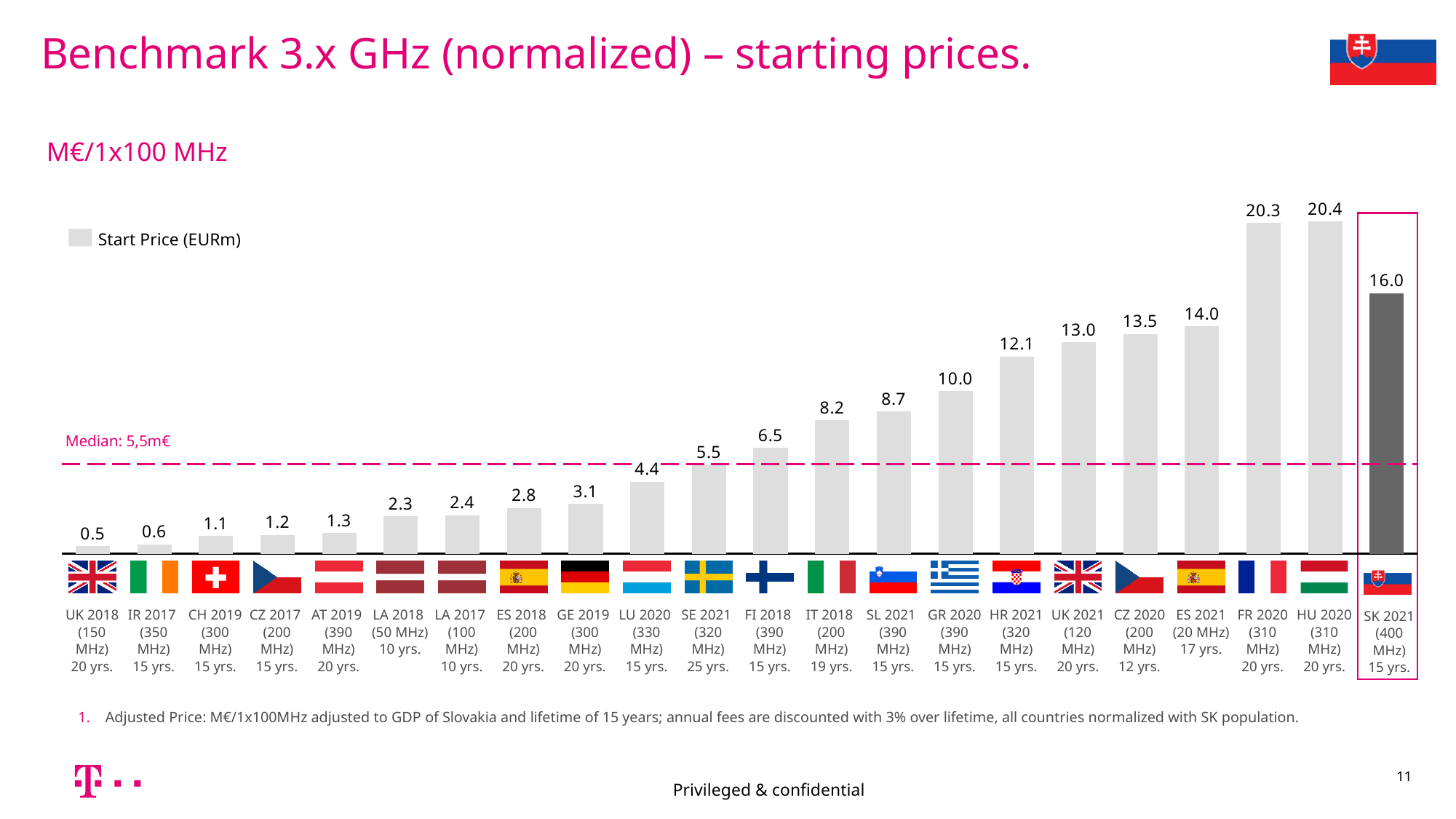
Which has a higher start price, ES 2021 or IT 2018? ES 2021 How many series does the legend list? 1 What is the start price for LA 2018? 2.3 How many countries/auctions are shown as bars in the chart? 22 What is the start price for GR 2020? 10.0 What median value is marked by the dashed line on the chart? 5,5m€ What kind of chart is shown on the slide? Bar chart What is the difference between the start prices of FI 2018 and LU 2020? 2.1 What is the start price for SE 2021? 5.5 What is the difference between the start prices of HU 2020 and SK 2021? 4.4 Which has a higher start price, CZ 2017 or GE 2019? GE 2019 What is the start price for SK 2021? 16.0